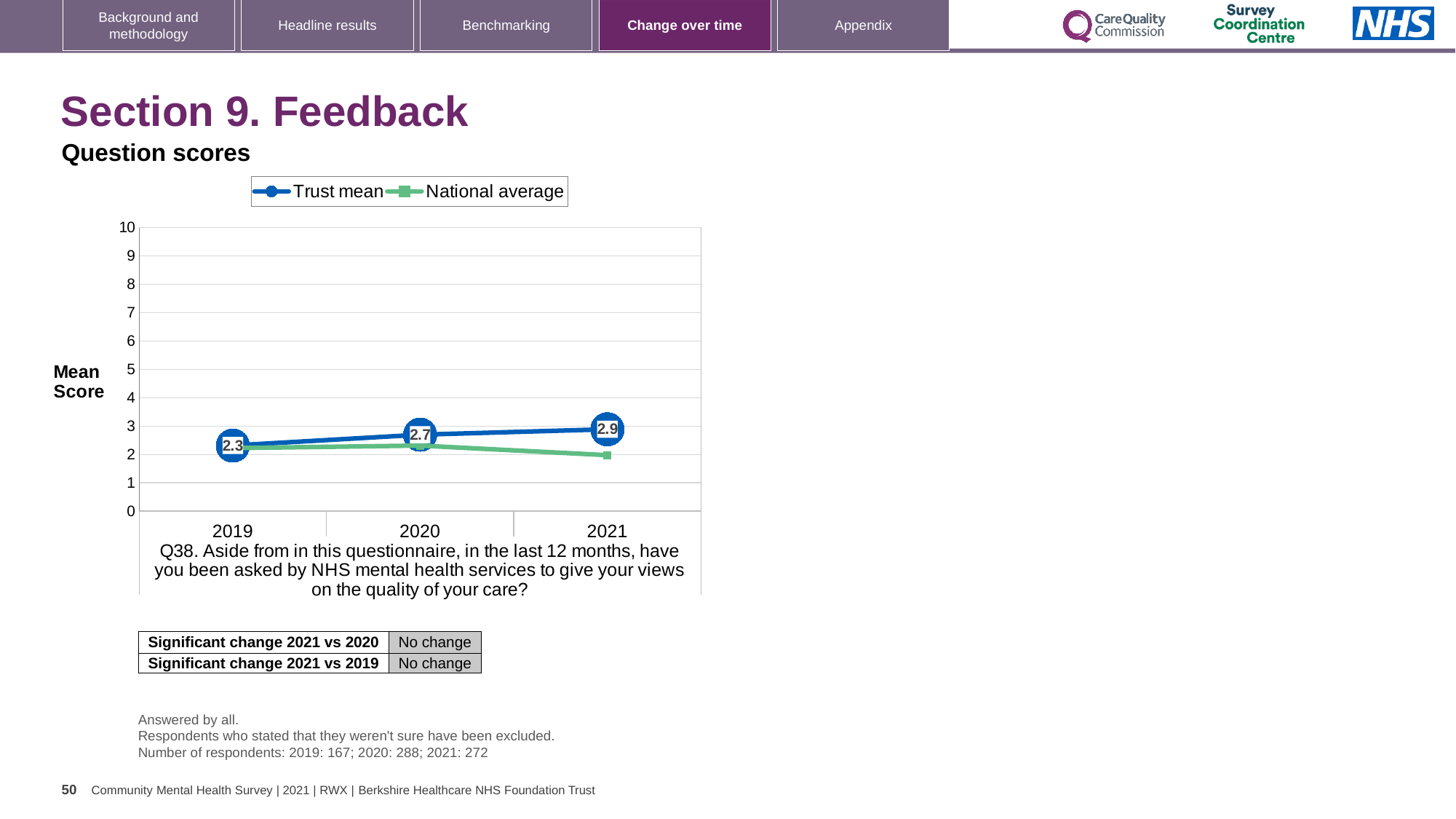
Which is larger in 2021, the Trust mean or the National average? Trust mean How many series does the legend list? 2 Is the National average value for 2021 greater or less than 3? less What is the Trust mean score for 2021? 2.9 In which year is the Trust mean score highest? 2021 What is the difference between the Trust mean score in 2021 and in 2019? 0.6 What kind of chart is shown on the slide? line chart How many years are plotted on the x axis? 3 What is the Trust mean score for 2020? 2.7 What is the Trust mean score for 2019? 2.3 Does the Trust mean rise or fall from 2019 to 2021? rise In which year is the Trust mean score lowest? 2019